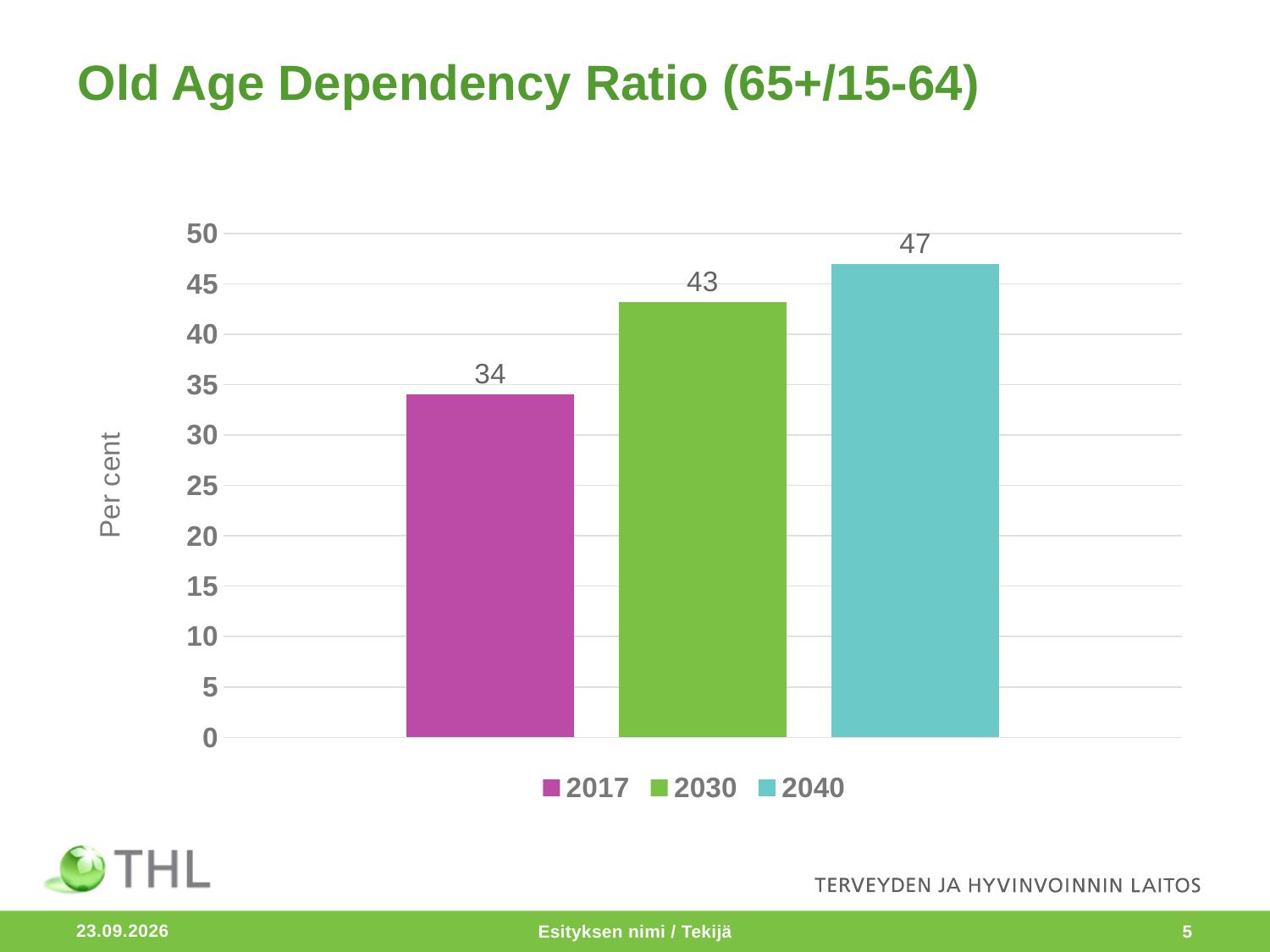
What is the old age dependency ratio for 2040? 47 What is the label of the vertical axis? Per cent What is the old age dependency ratio for 2017? 34 Which year has the lowest old age dependency ratio? 2017 What is the difference between the 2030 and 2017 values? 9 What is the difference between the 2040 and 2017 values? 13 What is the old age dependency ratio for 2030? 43 Which year has the highest old age dependency ratio? 2040 What kind of chart is shown on the slide? Bar chart Which is larger, the value for 2030 or the value for 2040? 2040 How many series does the legend list? 3 How many bars are shown in the chart? 3